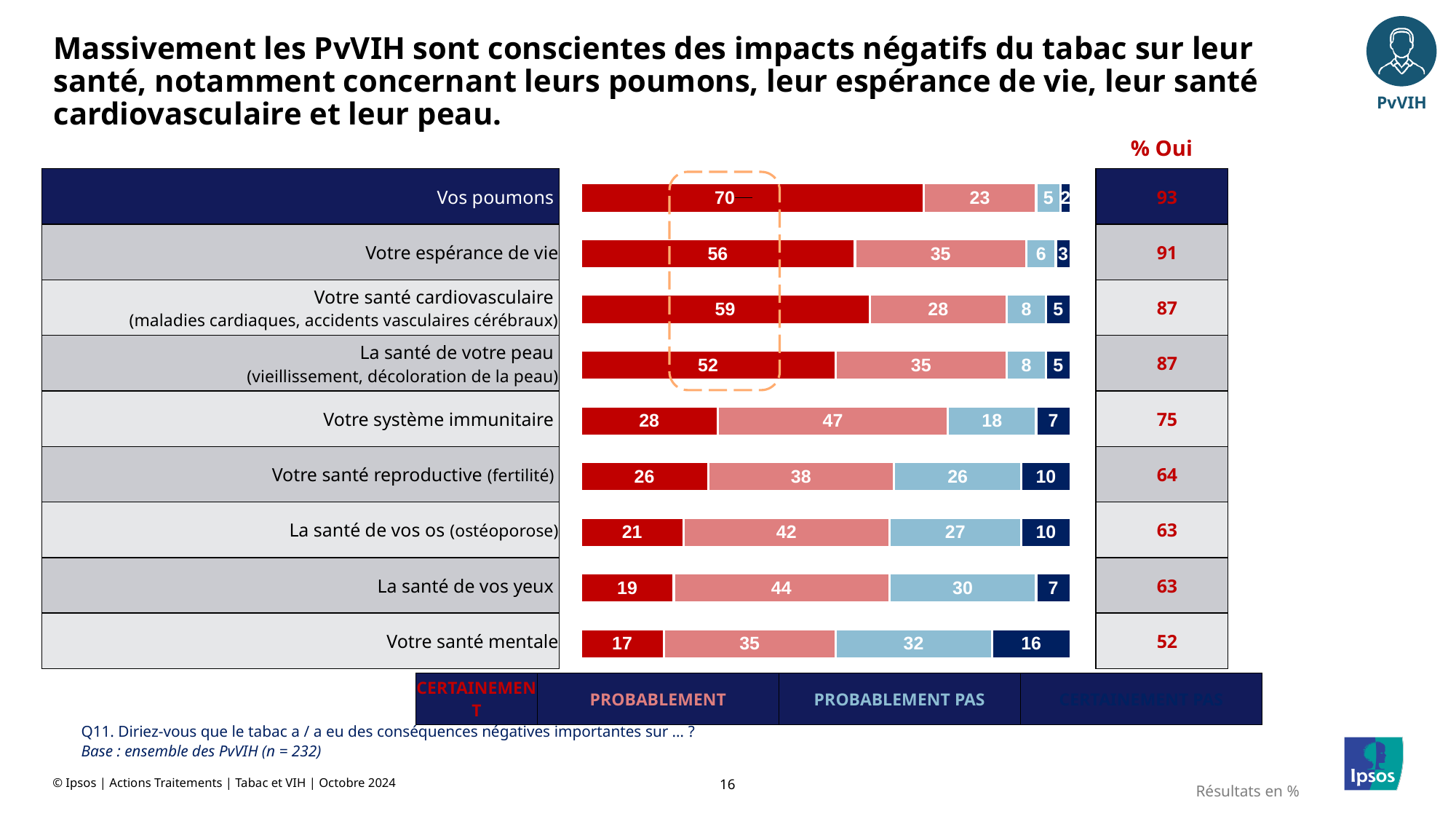
What is the heading of the column of totals on the right of the chart? % Oui What is the '% Oui' value for 'Votre système immunitaire'? 75 How many categories are shown in the chart? 9 What is the sum of the 'Certainement' and 'Probablement' values for 'La santé de vos os (ostéoporose)'? 63 Which category has the lowest '% Oui' value? Votre santé mentale Which has a larger 'Probablement pas' value: 'Votre santé mentale' or 'La santé de vos yeux'? Votre santé mentale What is the 'Certainement' value for 'Vos poumons'? 70 What kind of chart is shown on the slide? Stacked bar chart What is the 'Probablement' value for 'Votre santé mentale'? 35 Which category has the highest 'Certainement' value? Vos poumons What is the 'Probablement pas' value for 'Votre santé reproductive (fertilité)'? 26 What is the difference between the 'Certainement' values for 'Vos poumons' and 'Votre espérance de vie'? 14